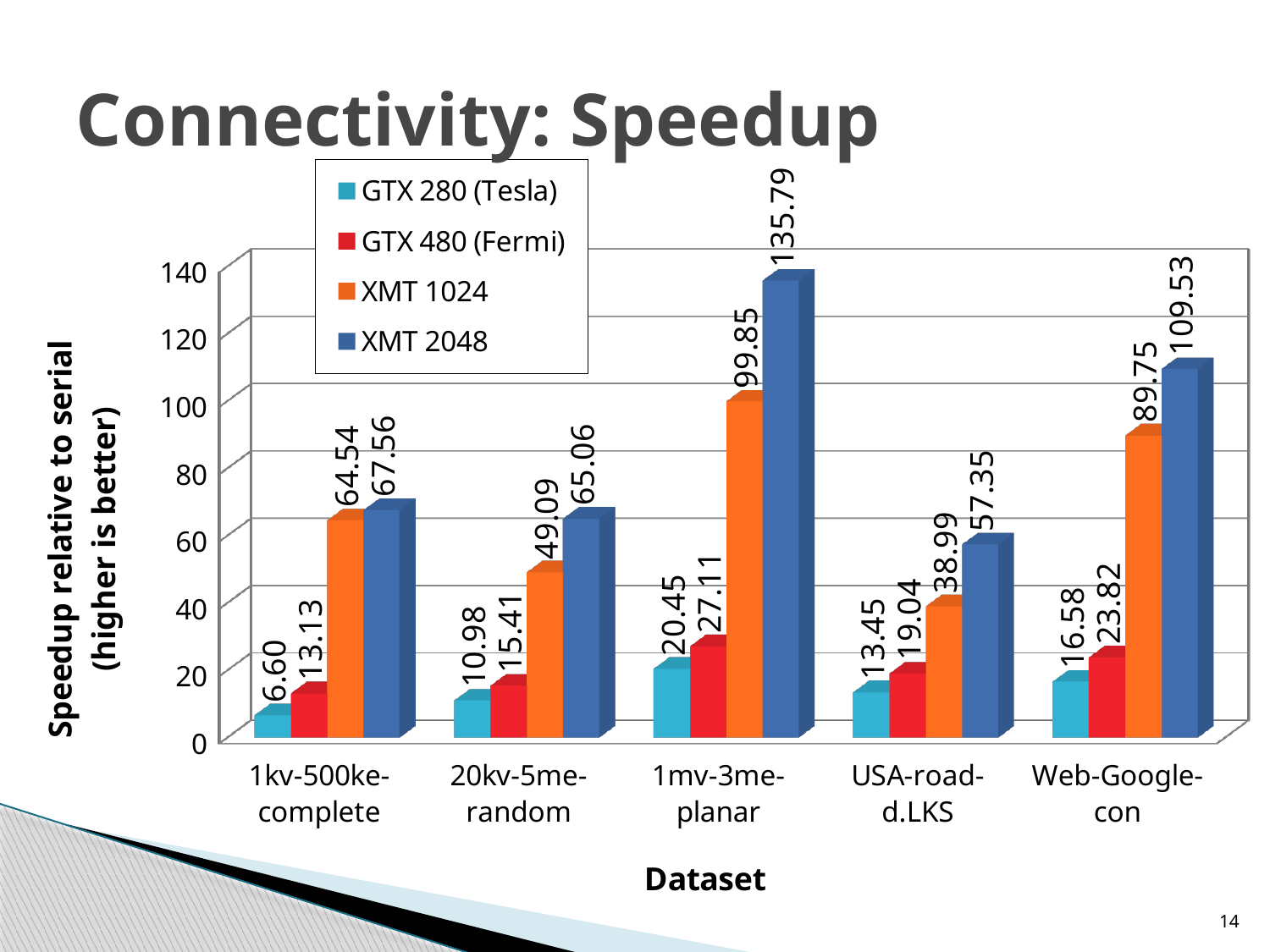
What is the label of the y axis? Speedup relative to serial (higher is better) Which is larger on the 20kv-5me-random dataset: the GTX 480 (Fermi) speedup or the XMT 1024 speedup? XMT 1024 Which dataset has the highest XMT 2048 speedup? 1mv-3me-planar How many datasets are shown on the x axis? 5 Which dataset has the lowest GTX 280 (Tesla) speedup? 1kv-500ke-complete How many series does the legend list? 4 What is the speedup for GTX 480 (Fermi) on the USA-road-d.LKS dataset? 19.04 What is the difference between the XMT 2048 and XMT 1024 speedups on the 1mv-3me-planar dataset? 35.94 What is the speedup for XMT 1024 on the Web-Google-con dataset? 89.75 What is the speedup for GTX 280 (Tesla) on the 1kv-500ke-complete dataset? 6.60 What kind of chart is shown on the slide? Bar chart What is the speedup for XMT 2048 on the 1mv-3me-planar dataset? 135.79